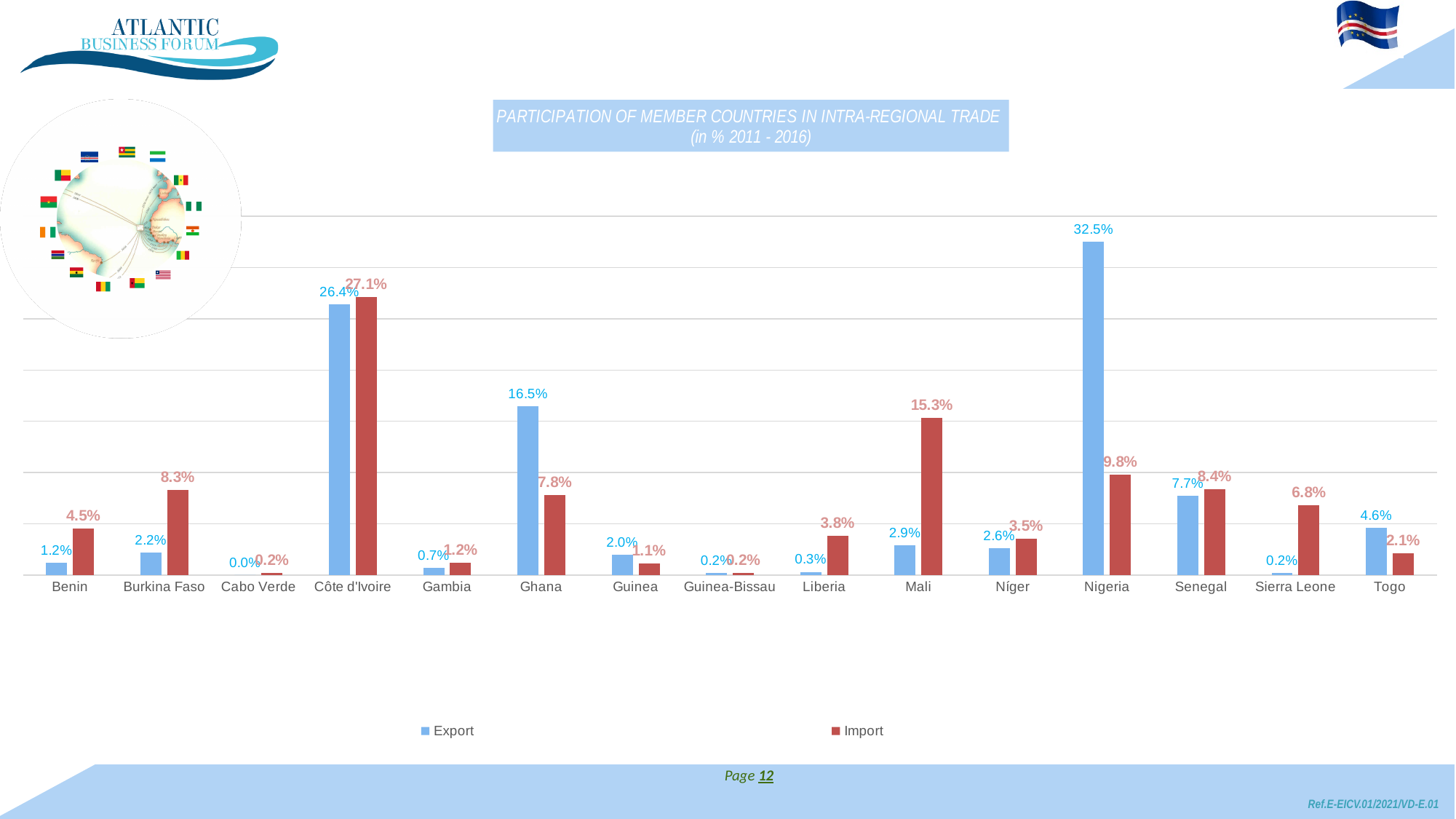
How many series does the legend list? 2 What type of chart is shown on the slide? Bar chart Which country has the highest Import value? Côte d'Ivoire What is the difference between the Import and Export values for Côte d'Ivoire? 0.7% Which country has the highest Export value? Nigeria What is the Import value for Sierra Leone? 6.8% What is the Export value for Nigeria? 32.5% How many countries are shown on the x axis? 15 What is the Export value for Ghana? 16.5% Which country has the lowest Export value? Cabo Verde Which is larger for Senegal, the Export value or the Import value? Import What is the Import value for Mali? 15.3%